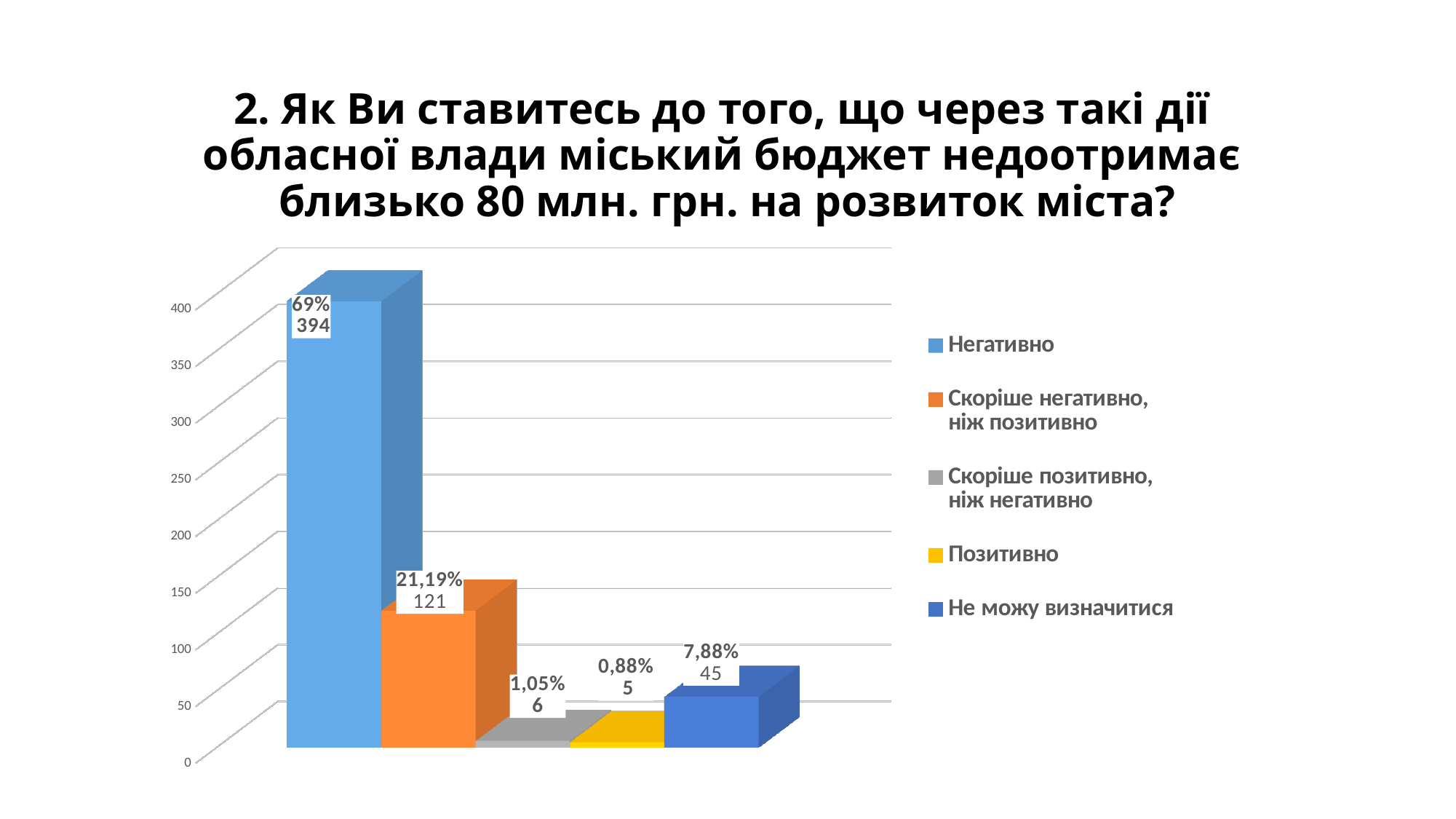
What percentage is shown for "Позитивно"? 0,88% Which category has the lowest value? Позитивно What is the count shown for "Не можу визначитися"? 45 Which category has the highest value? Негативно Which is larger: the count for "Не можу визначитися" or for "Скоріше позитивно, ніж негативно"? Не можу визначитися What kind of chart is shown on the slide? bar chart What percentage is shown for "Скоріше негативно, ніж позитивно"? 21,19% How many categories are plotted in the chart? 5 What is the difference between the counts for "Негативно" and "Скоріше негативно, ніж позитивно"? 273 How many entries does the legend list? 5 Is the value for "Скоріше негативно, ніж позитивно" greater or less than 100? greater What is the number of respondents for "Негативно"? 394